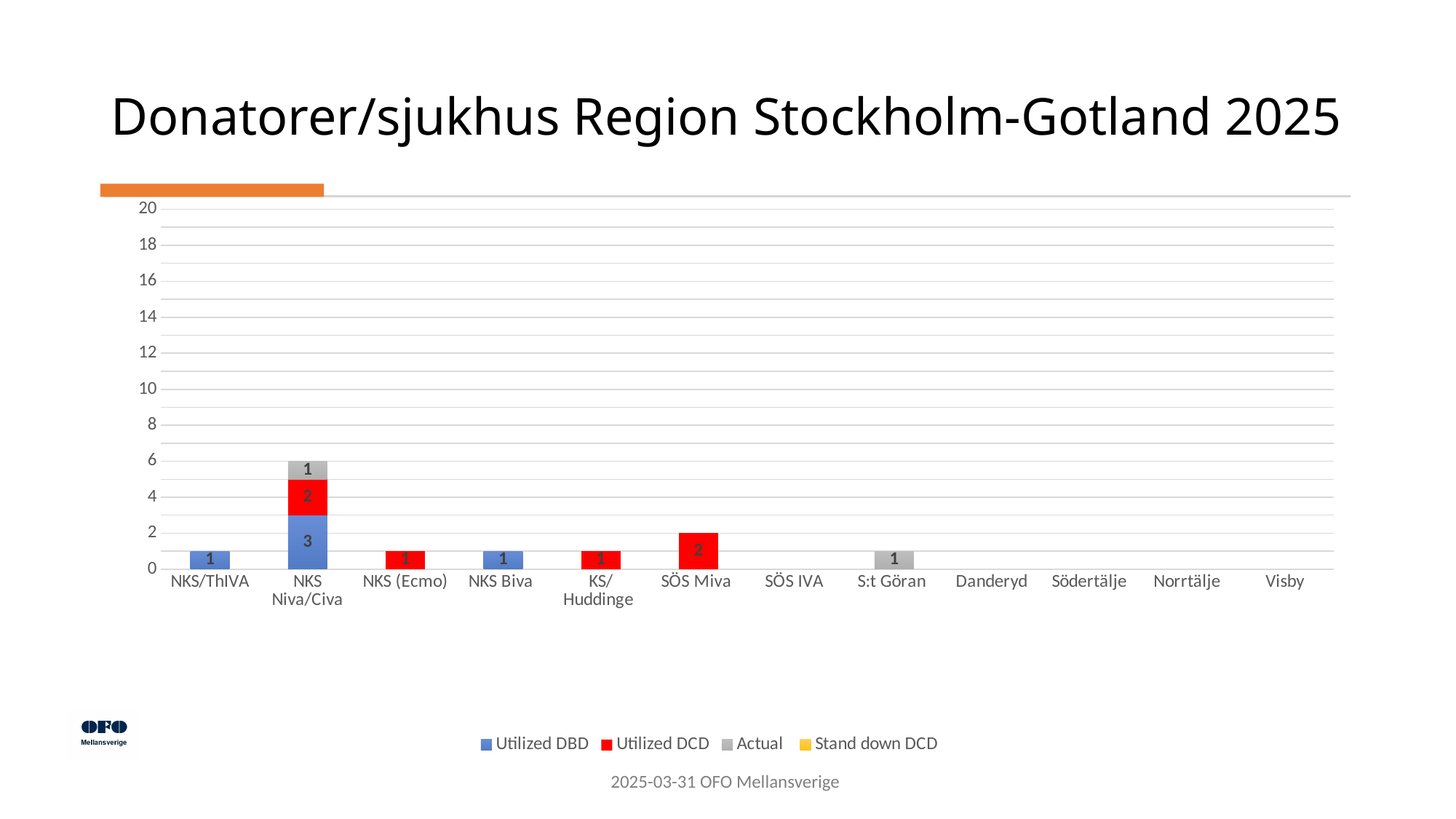
What kind of chart is shown on the slide? Stacked bar chart What is the title of the chart on the slide? Donatorer/sjukhus Region Stockholm-Gotland 2025 How many hospital categories are shown on the x axis? 12 Which is larger, the Utilized DCD value for SÖS Miva or the Utilized DCD value for KS/Huddinge? SÖS Miva Which hospital has the highest total stacked bar? NKS Niva/Civa What is the Actual value for S:t Göran? 1 What is the total of the stacked bar for NKS Niva/Civa? 6 How many series does the legend list? 4 What is the Utilized DCD value for NKS Niva/Civa? 2 What is the Utilized DCD value for SÖS Miva? 2 What is the Utilized DBD value for NKS Niva/Civa? 3 What is the difference between the Utilized DBD value and the Utilized DCD value for NKS Niva/Civa? 1